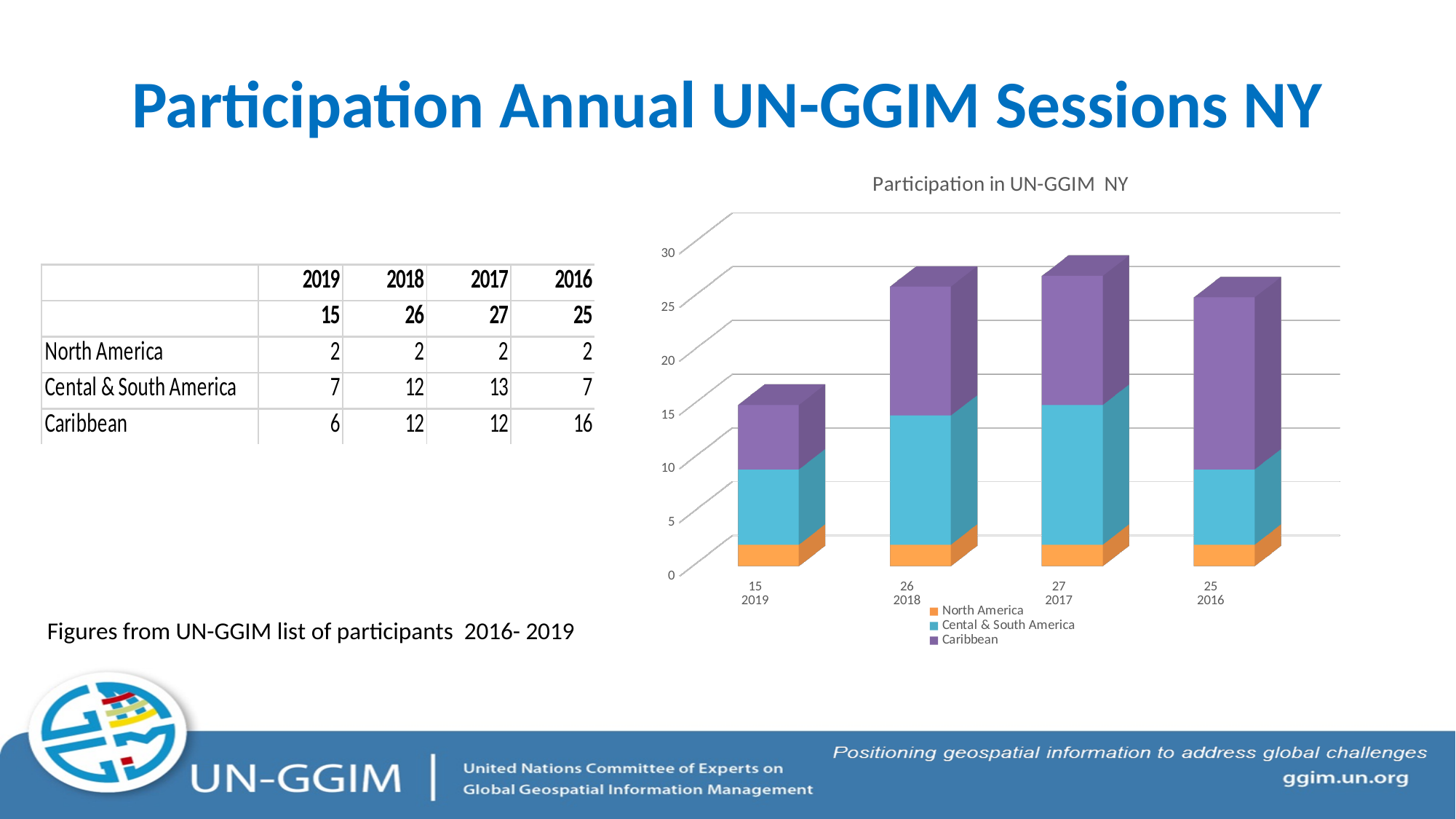
What is the total participation shown for 2019? 15 Is the total participation for 2016 greater or less than 20? greater How many bars (years) are plotted in the chart? 4 What type of chart is shown on the slide? stacked bar chart What is the Caribbean value for 2016? 16 What is the difference between the total participation in 2018 and 2019? 11 What is the total participation shown for 2017? 27 How many series does the chart legend list? 3 What is the title of the chart? Participation in UN-GGIM NY Which year has the lowest total participation? 2019 What is the Cental & South America value for 2017? 13 Which year has the highest total participation? 2017